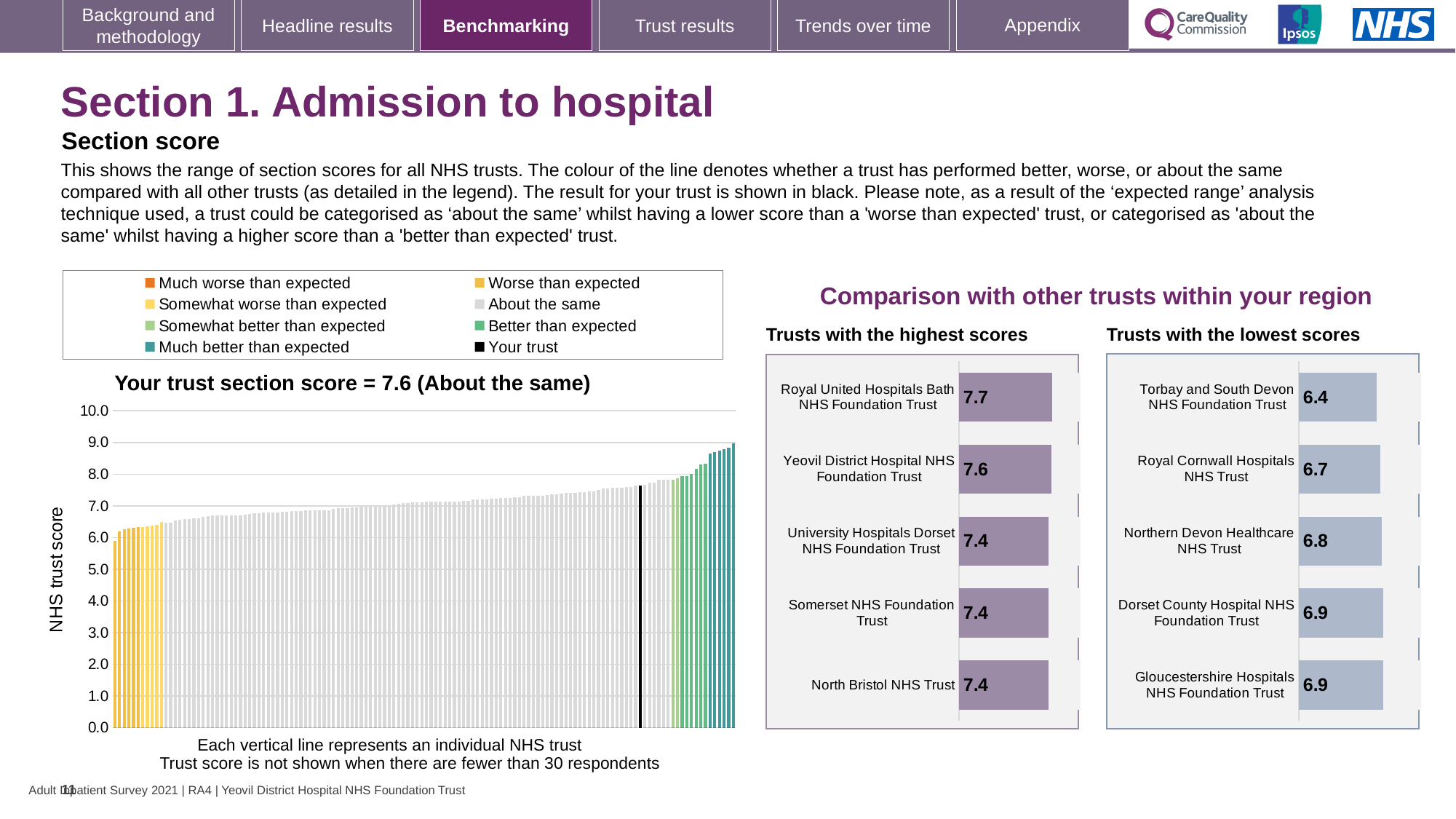
What kind of chart is the main chart on the left showing NHS trust scores? Bar chart In the 'Trusts with the highest scores' chart, which trust has the highest score? Royal United Hospitals Bath NHS Foundation Trust In the 'Trusts with the lowest scores' chart, which trust has the lowest score? Torbay and South Devon NHS Foundation Trust According to the title of the main chart on the left, what is your trust's section score? 7.6 In the 'Trusts with the lowest scores' chart, what is the difference between the scores of Gloucestershire Hospitals NHS Foundation Trust and Torbay and South Devon NHS Foundation Trust? 0.5 How many trusts are shown in the 'Trusts with the highest scores' chart? 5 In the 'Trusts with the highest scores' chart, what is the difference between the scores of Royal United Hospitals Bath NHS Foundation Trust and North Bristol NHS Trust? 0.3 How many entries does the legend above the main chart on the left list? 8 In the 'Trusts with the lowest scores' chart, which has the larger score: Royal Cornwall Hospitals NHS Trust or Northern Devon Healthcare NHS Trust? Northern Devon Healthcare NHS Trust In the main chart on the left, do the trust scores rise or fall from left to right? Rise In the 'Trusts with the highest scores' chart, what is the score for Royal United Hospitals Bath NHS Foundation Trust? 7.7 In the 'Trusts with the lowest scores' chart, what is the score for Torbay and South Devon NHS Foundation Trust? 6.4